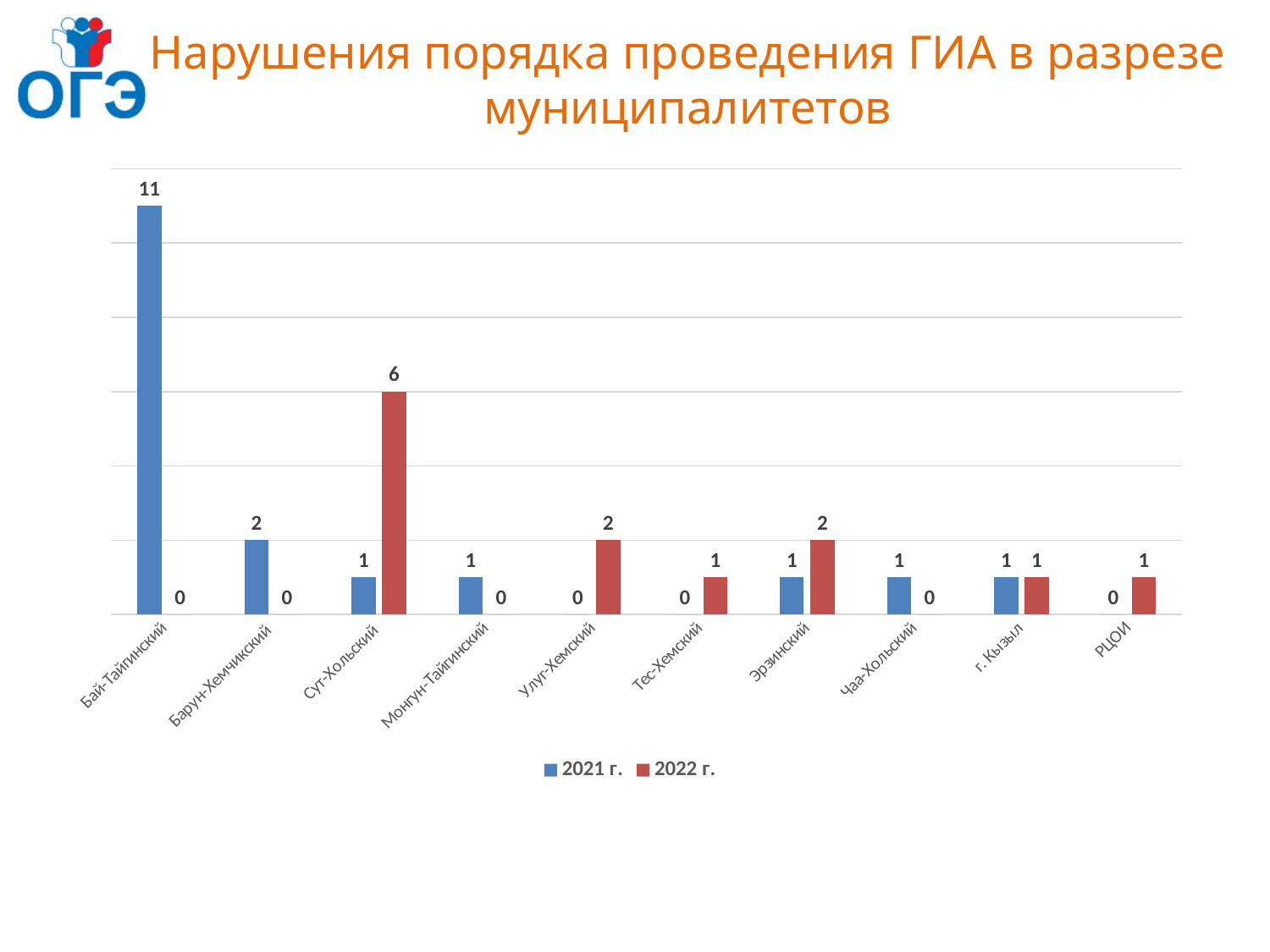
Which category has the highest value in the 2021 г. series? Бай-Тайгинский What is the value for Барун-Хемчикский in the 2021 г. series? 2 What is the value for Бай-Тайгинский in the 2021 г. series? 11 What is the total of the 2021 г. and 2022 г. values for г. Кызыл? 2 What kind of chart is shown on the slide? Bar chart What is the value for Сут-Хольский in the 2022 г. series? 6 How many series does the legend list? 2 What is the difference between the 2021 г. value for Бай-Тайгинский and the 2022 г. value for Сут-Хольский? 5 Which category has the highest value in the 2022 г. series? Сут-Хольский How many categories are shown on the x axis? 10 For Эрзинский, which series has the larger value, 2021 г. or 2022 г.? 2022 г. What is the value for Улуг-Хемский in the 2022 г. series? 2